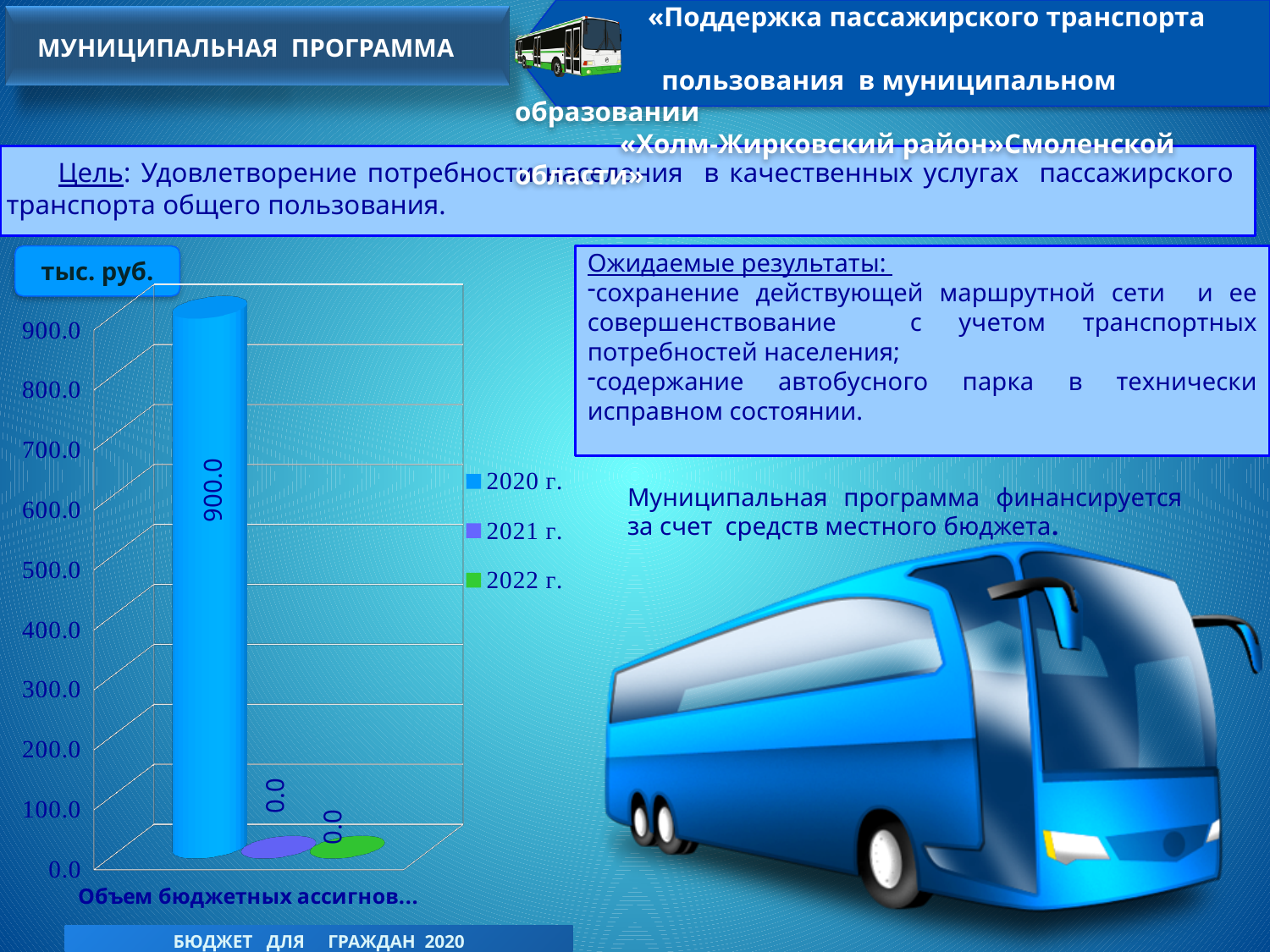
Do the values fall or rise from 2020 г. to 2022 г.? fall What is the value for 2022 г. in the chart? 0.0 What kind of chart is shown on the slide? bar chart Which is larger, the value for 2020 г. or the value for 2022 г.? 2020 г. How many series does the chart legend list? 3 What is the highest tick value shown on the vertical axis of the chart? 900.0 What is the difference between the values for 2020 г. and 2021 г.? 900.0 What is the value for 2021 г. in the chart? 0.0 What unit is shown in the label above the chart? тыс. руб. Which year has the highest value in the chart? 2020 г. What is the value for 2020 г. in the chart? 900.0 Is the value for 2020 г. greater or less than 500.0? greater